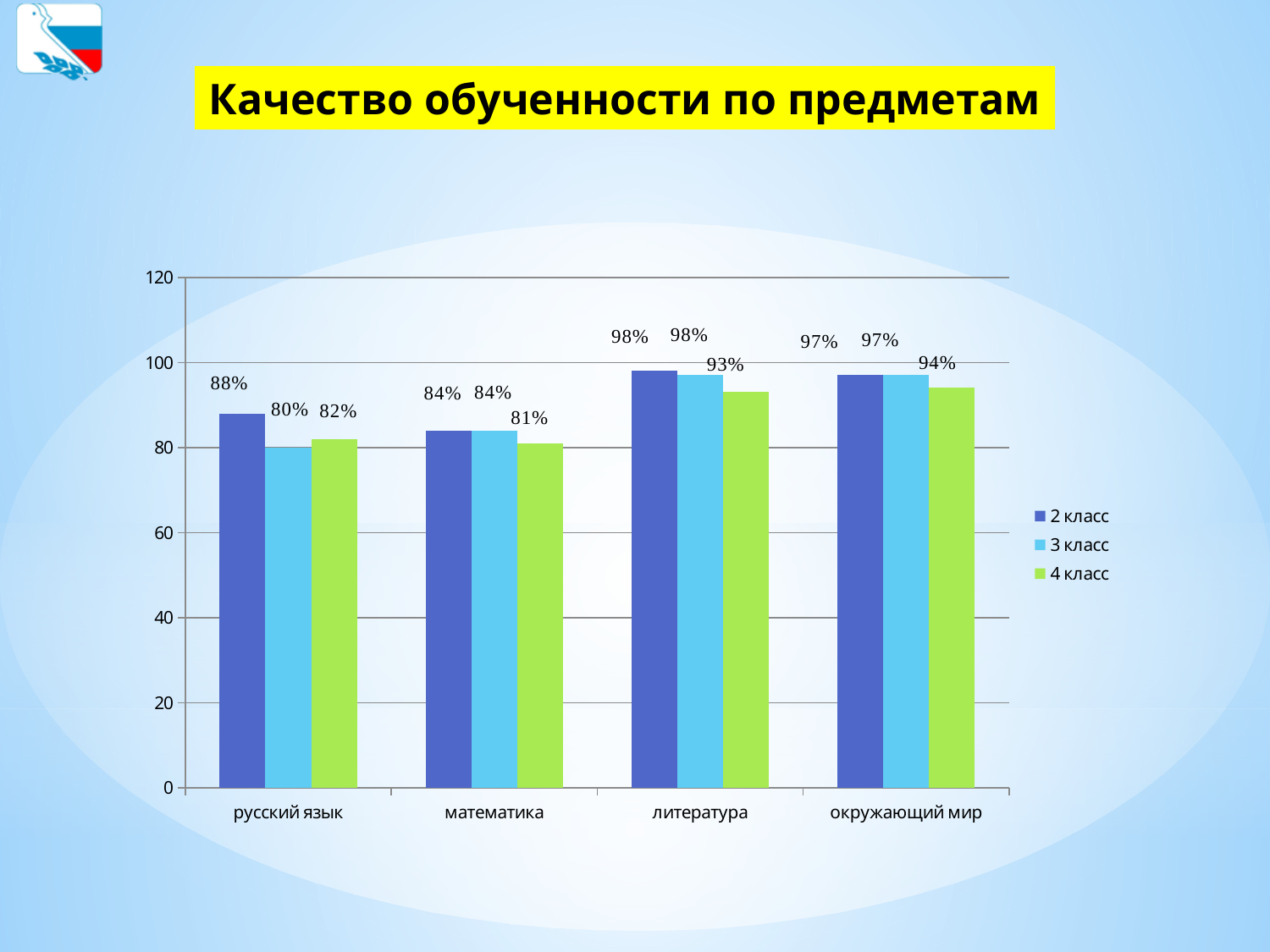
What kind of chart is shown on the slide? bar chart Which subject has the highest value for 2 класс? литература What is the difference between the 2 класс and 3 класс values in русский язык? 8% Is the value for 4 класс in математика greater or less than 100? less What is the value for 4 класс in литература? 93% What is the value for 3 класс in математика? 84% How many series does the legend list? 3 Which is larger in окружающий мир: the value for 2 класс or for 4 класс? 2 класс Which subject has the lowest value for 3 класс? русский язык What is the title of the slide? Качество обученности по предметам How many subjects are shown on the x axis? 4 What is the value for 2 класс in русский язык? 88%